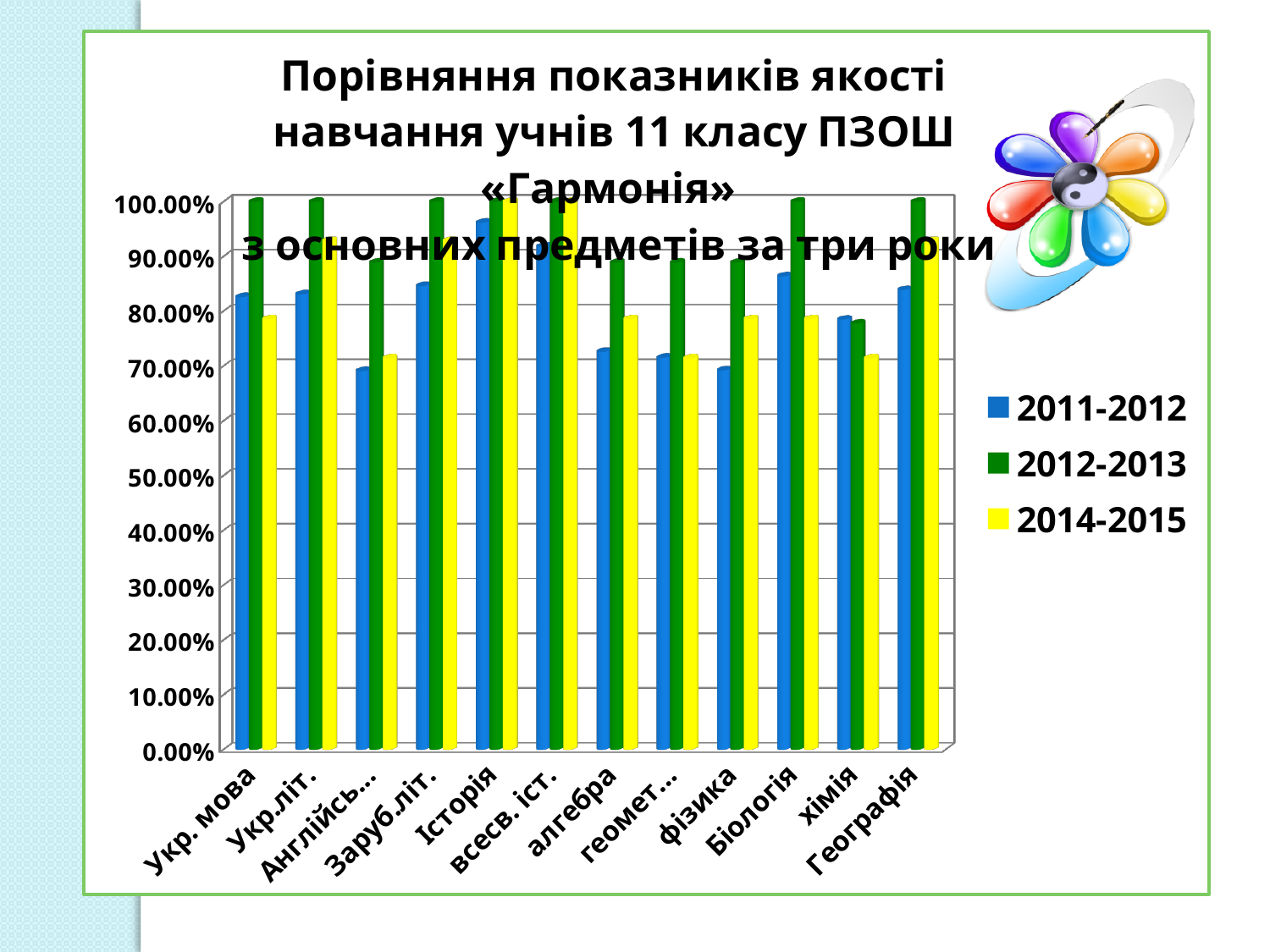
Which school years are listed in the legend? 2011-2012, 2012-2013, 2014-2015 Is the 2011-2012 value for алгебра greater or less than 80.00%? less How many subject categories are shown on the x axis? 12 Is the 2012-2013 value for фізика greater or less than 80.00%? greater Is the 2011-2012 value for Біологія greater or less than 80.00%? greater What kind of chart is shown on the slide? bar chart For укр. мова, which is larger: the 2012-2013 value or the 2014-2015 value? 2012-2013 How many series does the legend list? 3 In the 2011-2012 series, which is larger: Історія or алгебра? Історія Which colour represents the 2014-2015 series? yellow